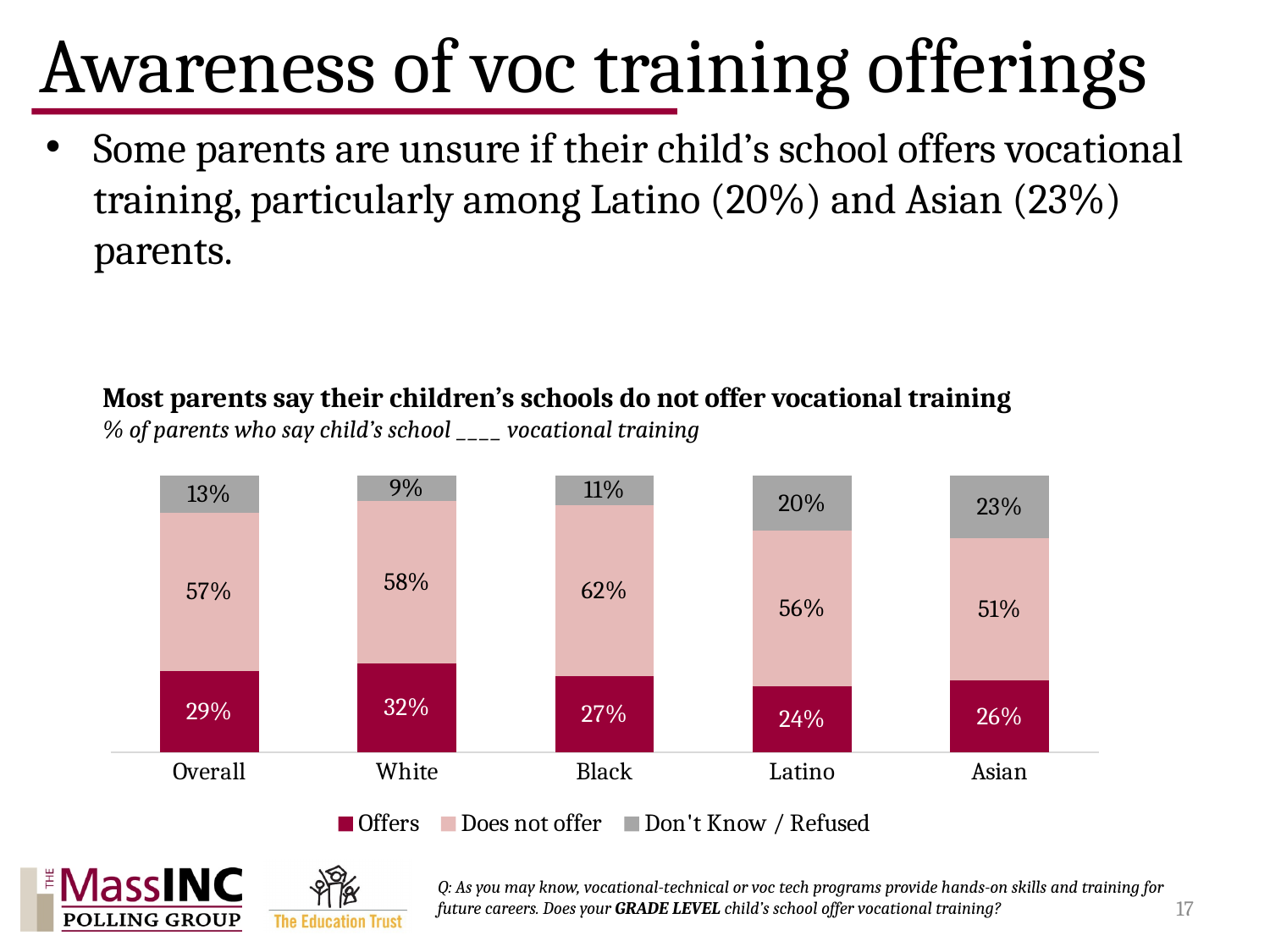
Which group has the lowest 'Don't Know / Refused' value? White What is the 'Don't Know / Refused' value for Asian parents? 23% What is the chart's title? Most parents say their children's schools do not offer vocational training What percentage of Latino parents say their child's school offers vocational training? 24% What is the difference between the 'Does not offer' values for Black and Asian parents? 11 percentage points What is the total of the three segments in the Overall bar? 99% Which is larger: the 'Offers' value for Overall or for Latino? Overall How many series does the legend list? 3 What kind of chart is shown on the slide? Stacked bar chart What is the 'Does not offer' value for Black parents? 62% Which group has the highest 'Offers' value? White How many groups are shown on the x axis? 5